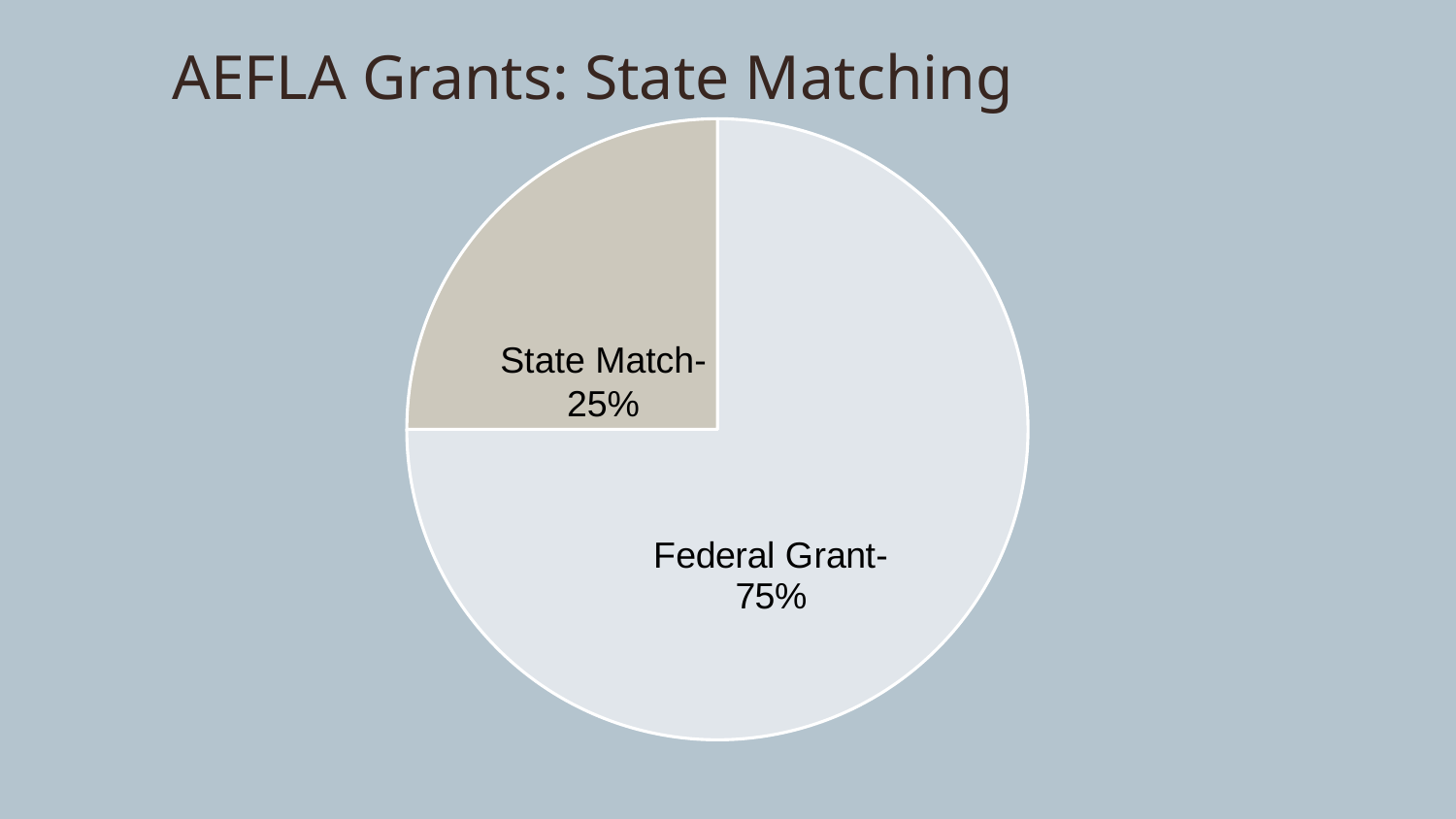
What is the title of the slide containing the chart? AEFLA Grants: State Matching Which is larger, the State Match slice or the Federal Grant slice? Federal Grant What share of the pie does the State Match slice represent? 25% What kind of chart is shown on the slide? pie chart Which slice is the smallest? State Match What is the total of the two slice percentages shown? 100% Which slice is the largest? Federal Grant What share of the pie does the Federal Grant slice represent? 75% What is the difference in percentage points between the Federal Grant and State Match slices? 50 How many slices does the pie chart have? 2